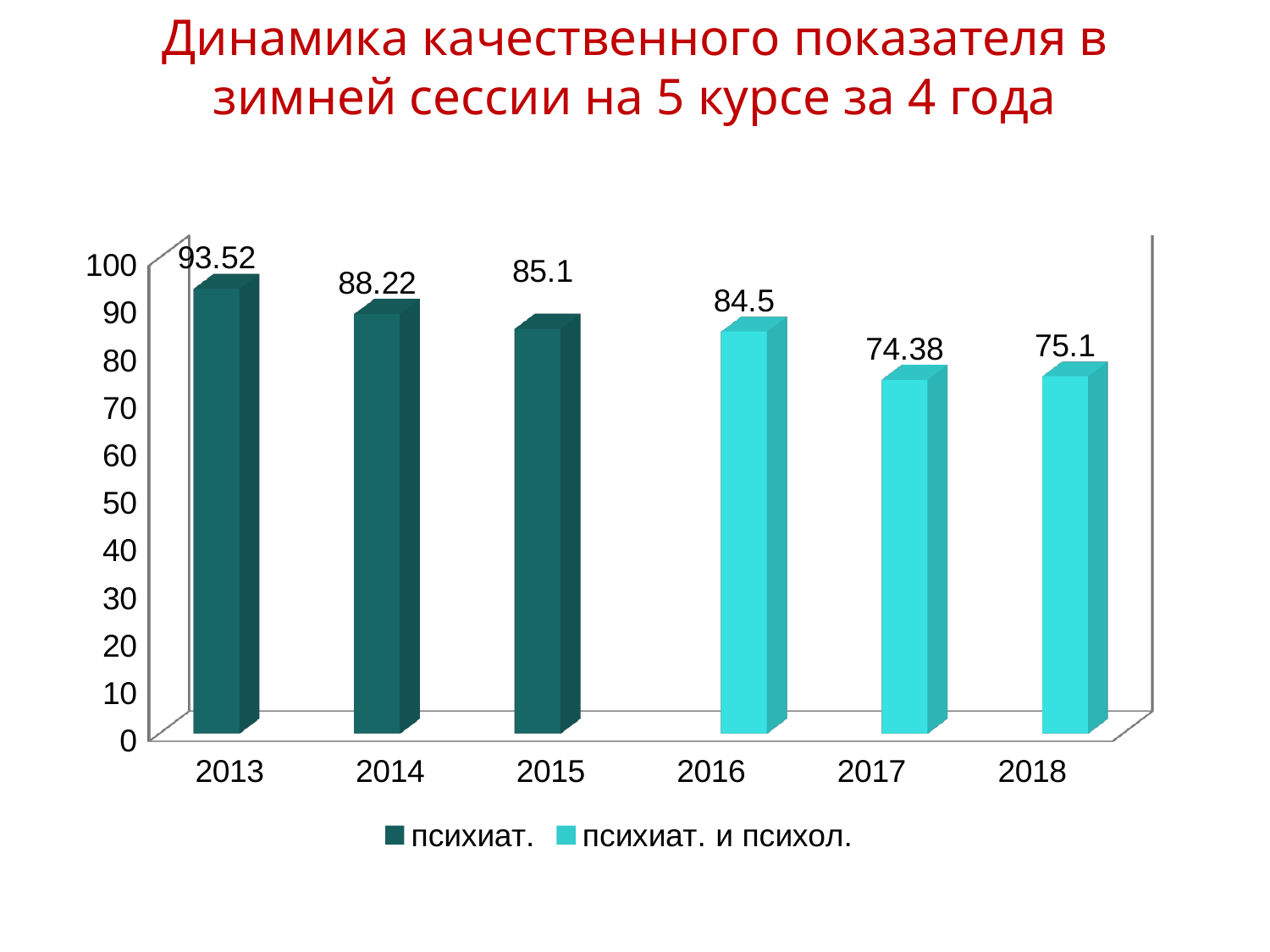
How many series does the legend list? 2 What is the difference between the values for 2016 and 2018? 9.4 What is the value for 2017? 74.38 What kind of chart is this? bar chart What is the value for 2016? 84.5 Which is larger, the value for 2015 or the value for 2016? 2015 What is the difference between the values for 2013 and 2014? 5.3 Which year has the highest value? 2013 Which year has the lowest value? 2017 How many years are shown on the x axis? 6 Which series do the bars for 2016 to 2018 belong to, according to the legend? психиат. и психол. What is the value for 2013? 93.52